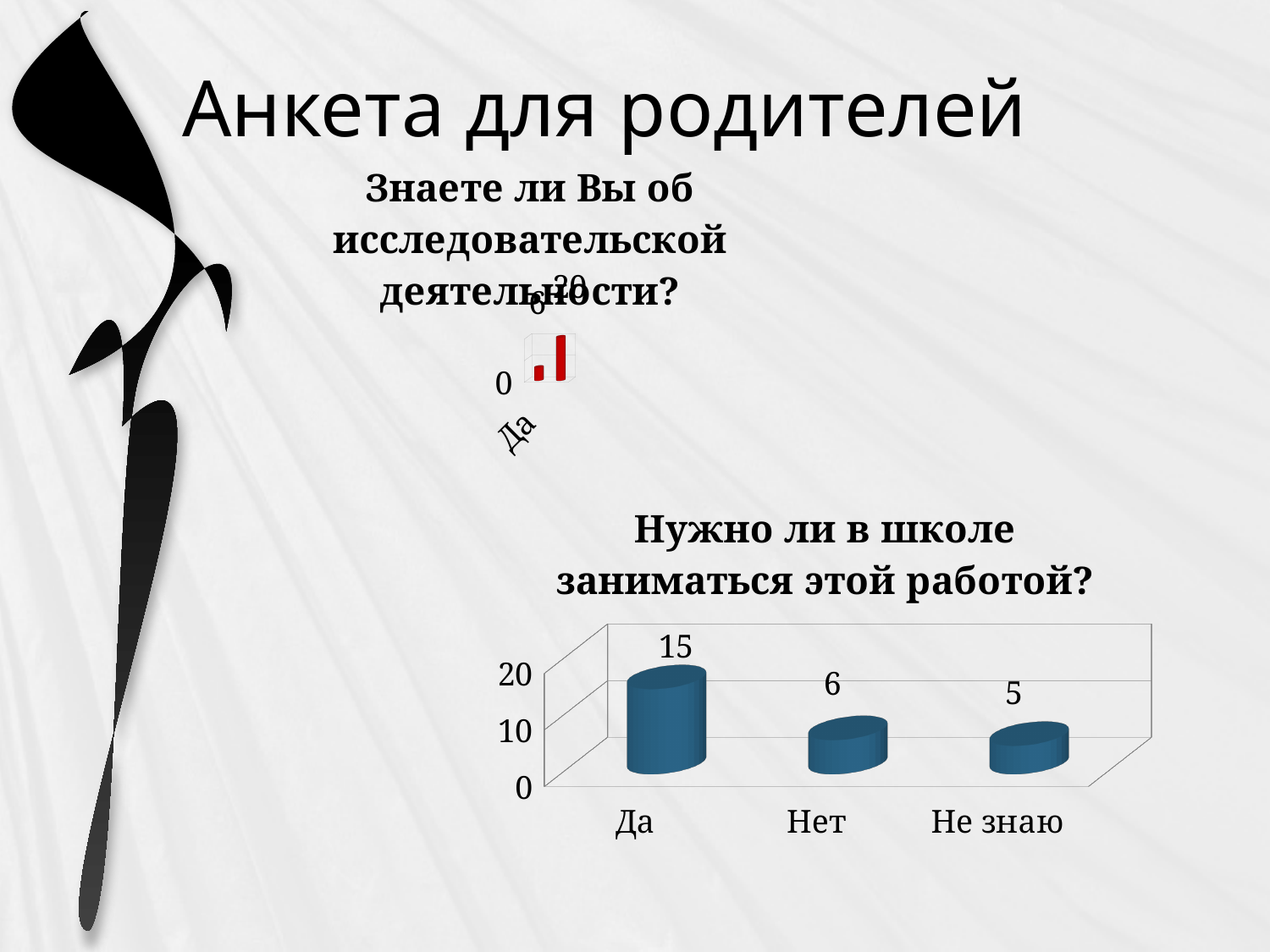
In the chart titled "Нужно ли в школе заниматься этой работой?", what is the difference between the values for "Нет" and "Не знаю"? 1 In the chart titled "Нужно ли в школе заниматься этой работой?", which category has the highest value? Да How many categories are shown in the chart titled "Нужно ли в школе заниматься этой работой?"? 3 In the chart titled "Нужно ли в школе заниматься этой работой?", which is larger, the value for "Да" or the value for "Нет"? Да In the chart titled "Нужно ли в школе заниматься этой работой?", what is the value for "Нет"? 6 What kind of chart is the chart titled "Нужно ли в школе заниматься этой работой?"? bar chart In the chart titled "Нужно ли в школе заниматься этой работой?", what is the value for "Не знаю"? 5 In the chart titled "Нужно ли в школе заниматься этой работой?", what is the value for "Да"? 15 In the chart titled "Нужно ли в школе заниматься этой работой?", is the value for "Да" greater or less than 10? greater In the chart titled "Нужно ли в школе заниматься этой работой?", which category has the lowest value? Не знаю In the chart titled "Нужно ли в школе заниматься этой работой?", what is the difference between the values for "Да" and "Нет"? 9 What is the title of the chart at the bottom of the slide? Нужно ли в школе заниматься этой работой?